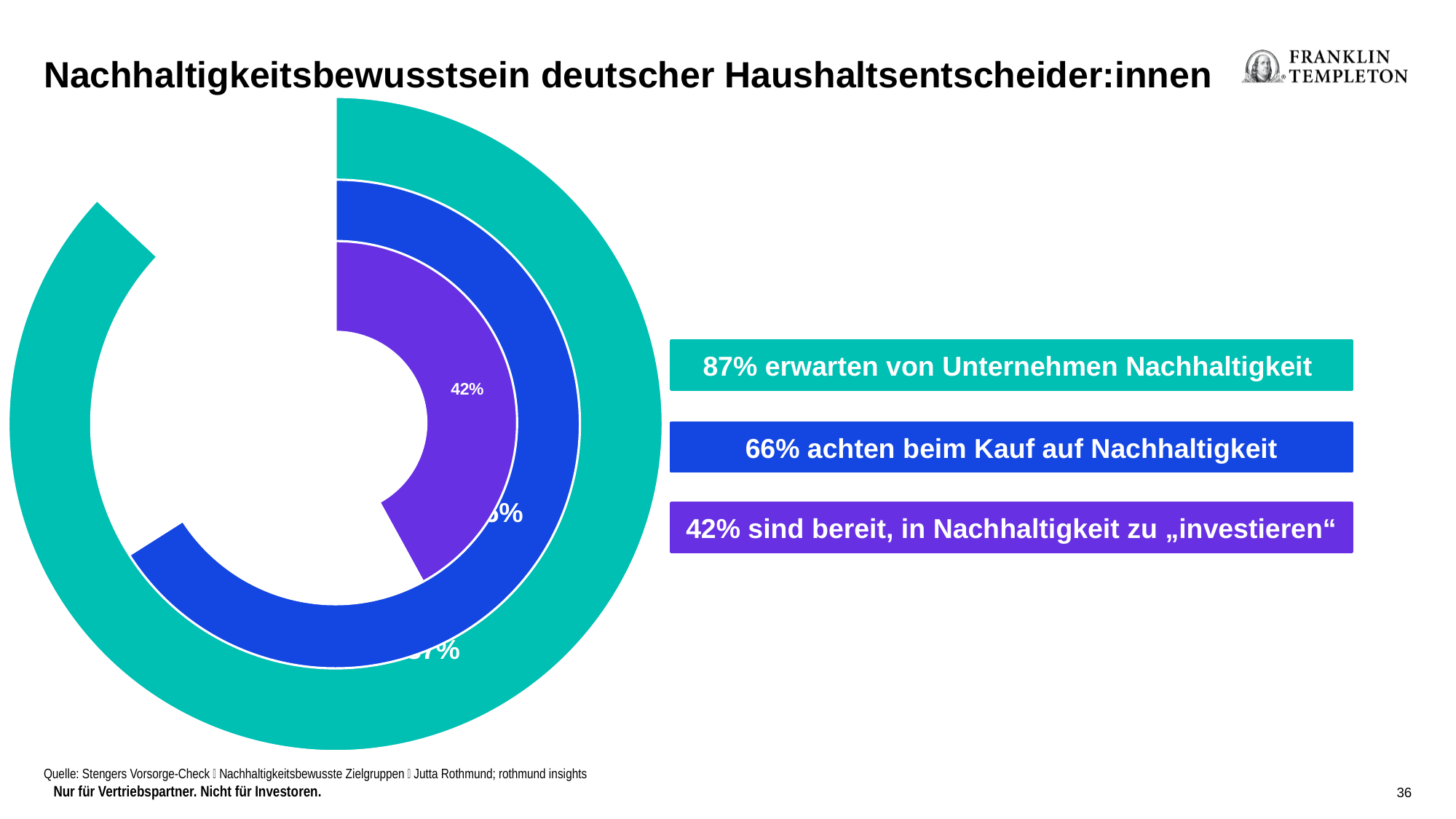
Which statement has the highest percentage in the chart? 87% erwarten von Unternehmen Nachhaltigkeit What is the difference in percentage points between those who pay attention to sustainability when buying and those willing to invest in sustainability? 24 percentage points What kind of chart is shown on the slide? A concentric donut (ring) chart How many rings (data values) does the chart show? 3 What share of German household decision-makers expect sustainability from companies ("erwarten von Unternehmen Nachhaltigkeit")? 87% What is the difference in percentage points between those who expect sustainability from companies and those who pay attention to sustainability when buying? 21 percentage points Which is larger: the share that pays attention to sustainability when buying or the share willing to invest in sustainability? The share that pays attention to sustainability when buying (66%) Which colour is the outermost ring representing 87%? Teal Which statement has the lowest percentage in the chart? 42% sind bereit, in Nachhaltigkeit zu „investieren“ What percentage pay attention to sustainability when buying ("achten beim Kauf auf Nachhaltigkeit")? 66% What is the difference in percentage points between the outer ring (87%) and the inner ring (42%)? 45 percentage points What percentage are willing to invest in sustainability ("sind bereit, in Nachhaltigkeit zu investieren")? 42%